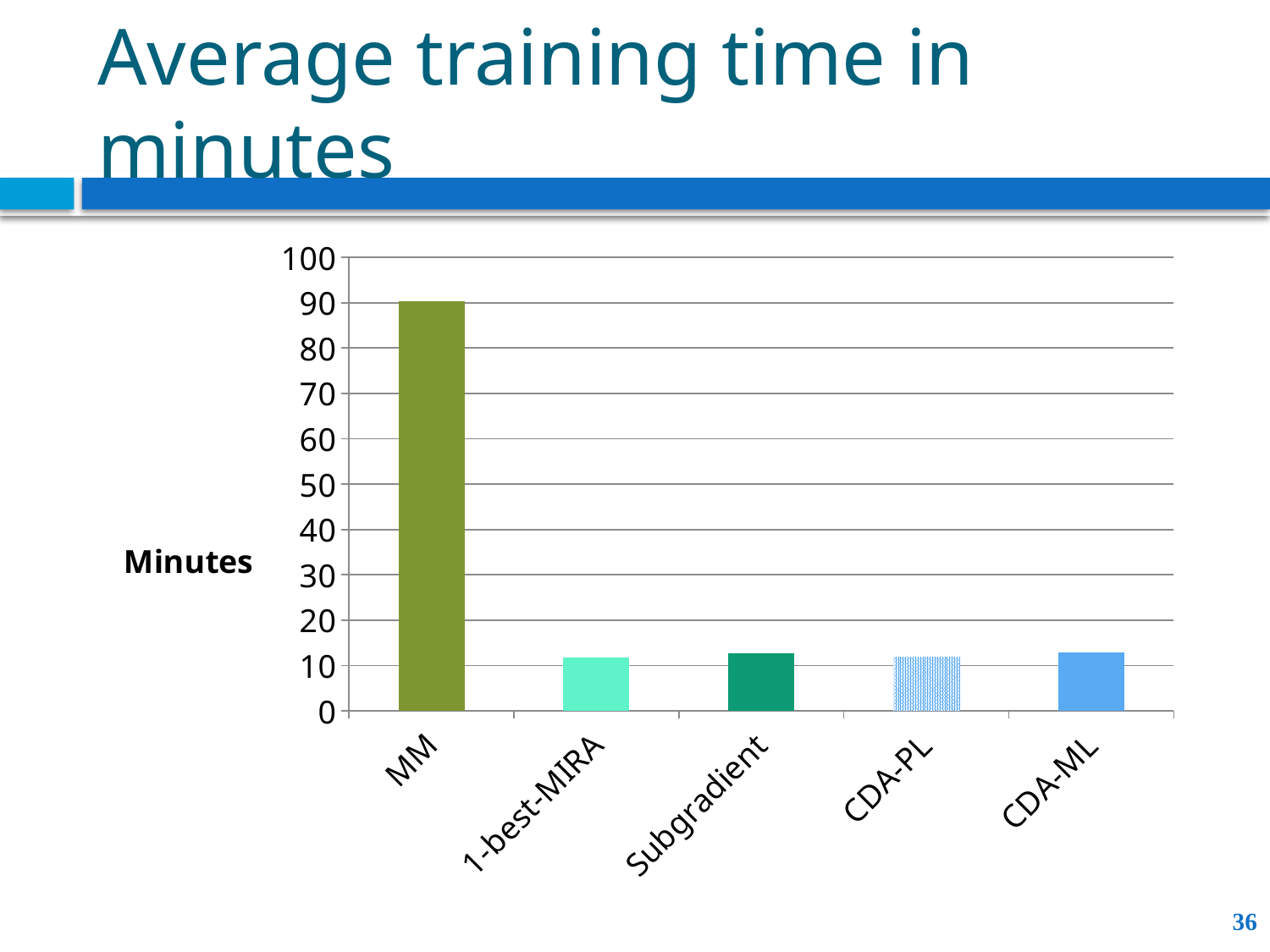
What is the title of the slide containing the chart? Average training time in minutes Is the value for 1-best-MIRA greater or less than 20? less Which is larger, the value for Subgradient or the value for MM? MM What kind of chart is shown on the slide? bar chart What is the label on the vertical axis of the chart? Minutes Is the value for MM greater or less than 80? greater Is the value for CDA-ML greater or less than 50? less Which category has the highest average training time? MM How many categories are shown on the x axis of the chart? 5 Which is larger, the value for MM or the value for CDA-PL? MM